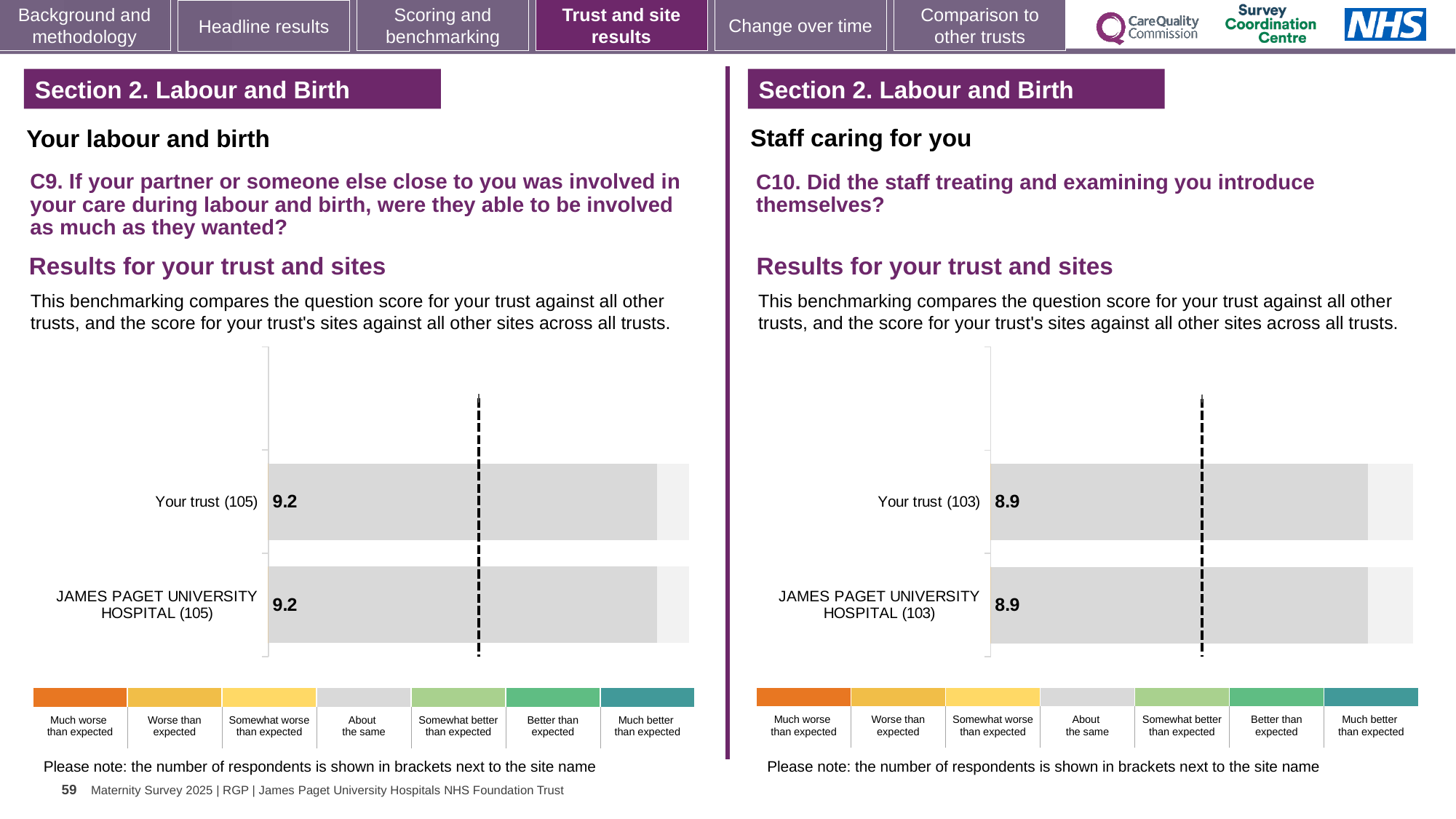
In the right chart (C10), is the score for Your trust larger than, smaller than, or equal to the score for James Paget University Hospital? equal How many bars are plotted in the left chart (C9)? 2 How many bars are plotted in the right chart (C10)? 2 In the left chart (C9), what is the score for James Paget University Hospital? 9.2 In the right chart (C10), what is the score for Your trust? 8.9 In the left chart (C9), what is the difference between the score for Your trust and the score for James Paget University Hospital? 0 In the left chart (C9), how many respondents are shown in brackets for Your trust? 105 In the right chart (C10), how many respondents are shown in brackets for James Paget University Hospital? 103 What kind of chart is used on the left for question C9? Bar chart In the right chart (C10), what is the score for James Paget University Hospital? 8.9 In the left chart (C9), what is the score for Your trust? 9.2 In the right chart (C10), which benchmark category does the grey colour of the bars correspond to in the legend? About the same